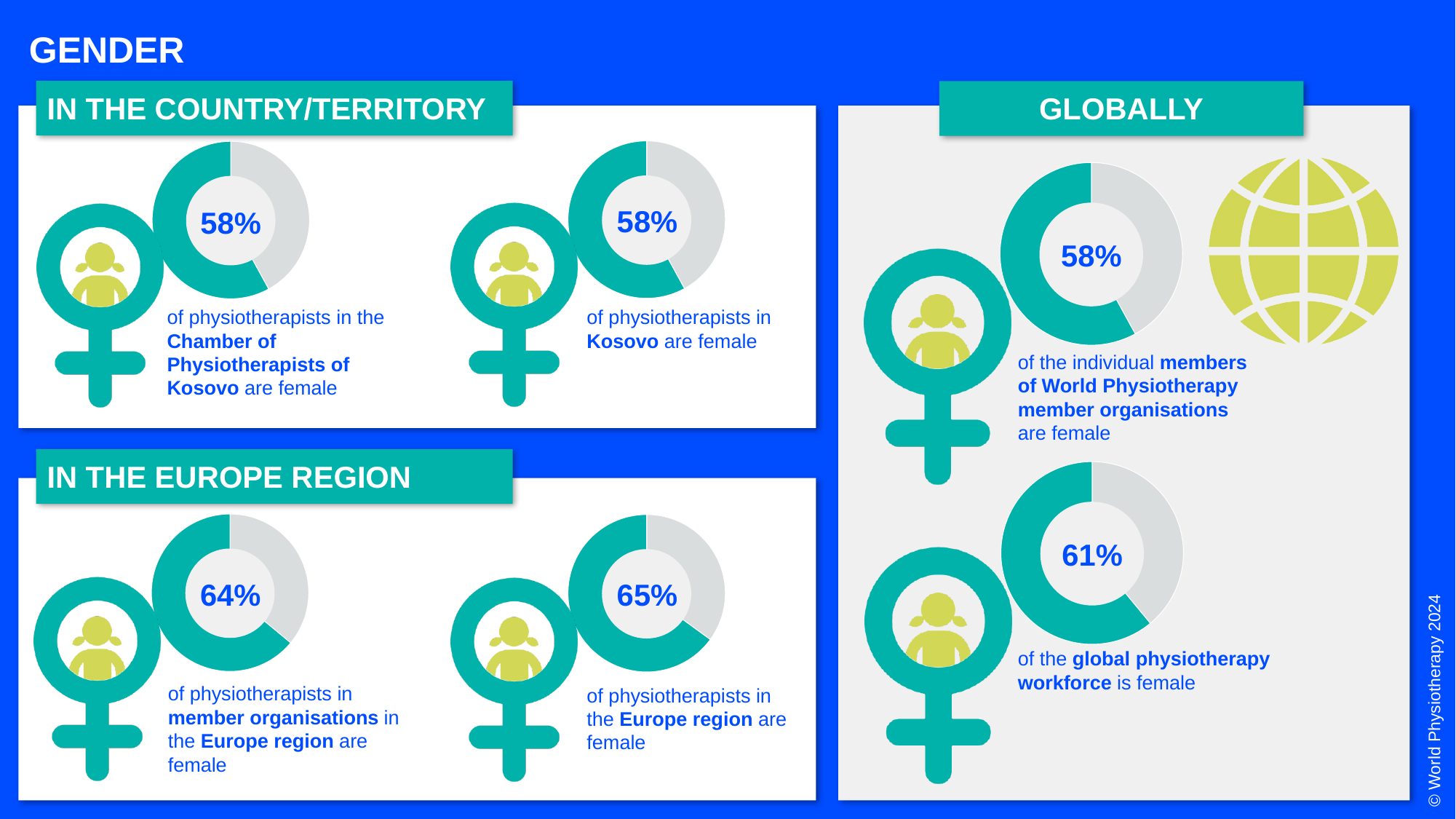
In the 'Globally' section, what percentage of the global physiotherapy workforce is female? 61% In the 'In the Europe region' section, what percentage of physiotherapists in the Europe region are female? 65% Which is larger: the percentage of female physiotherapists in the Europe region or the percentage of female physiotherapists in Kosovo? Europe region In the 'In the Europe region' section, what percentage of physiotherapists in member organisations in the Europe region are female? 64% Across all six donut charts on the slide, which group has the highest percentage of female physiotherapists? Physiotherapists in the Europe region (65%) In the 'Globally' section, what percentage of the individual members of World Physiotherapy member organisations are female? 58% What is the difference between the percentage of female physiotherapists in the Europe region and the percentage of female physiotherapists in Kosovo? 7 percentage points What kind of chart is used to show the percentages on this slide? Donut chart How many donut charts are shown on the slide? 6 What is the difference between the percentage of the global physiotherapy workforce that is female and the percentage of individual members of World Physiotherapy member organisations that are female? 3 percentage points In the 'In the country/territory' section, what percentage of physiotherapists in Kosovo are female? 58% In the 'In the country/territory' section, what percentage of physiotherapists in the Chamber of Physiotherapists of Kosovo are female? 58%